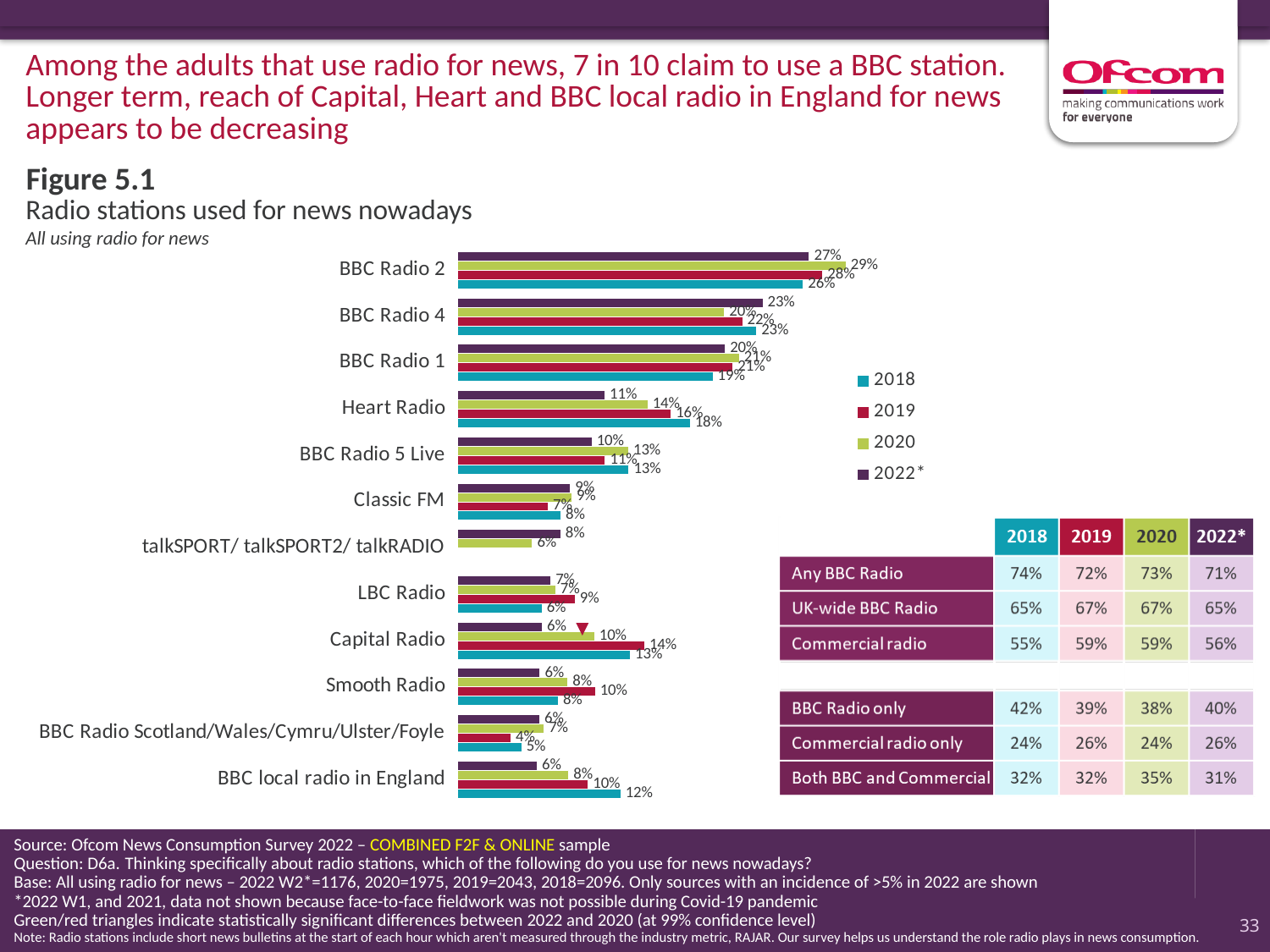
In the 'Radio stations used for news nowadays' chart, what is the difference between the 2018 and 2022* values for Heart Radio? 7 percentage points In the 'Radio stations used for news nowadays' chart, what is the 2019 value for BBC local radio in England? 10% In the table on the slide, what is the 2020 value for Both BBC and Commercial? 35% What type of chart is used in Figure 5.1, 'Radio stations used for news nowadays'? Bar chart In the 'Radio stations used for news nowadays' chart, which radio station has the highest 2022* value? BBC Radio 2 In the 'Radio stations used for news nowadays' chart, what is the 2022* value for Capital Radio? 6% In the 'Radio stations used for news nowadays' chart, what is the 2018 value for Heart Radio? 18% How many series does the legend of the 'Radio stations used for news nowadays' chart list? 4 In the table on the slide, what is the 2022* value for Any BBC Radio? 71% In the 'Radio stations used for news nowadays' chart, do the values for BBC local radio in England rise or fall from 2018 to 2022*? Fall How many radio stations (categories) are shown in the 'Radio stations used for news nowadays' chart? 12 In the 'Radio stations used for news nowadays' chart, which is larger for Capital Radio: the 2019 value or the 2020 value? 2019